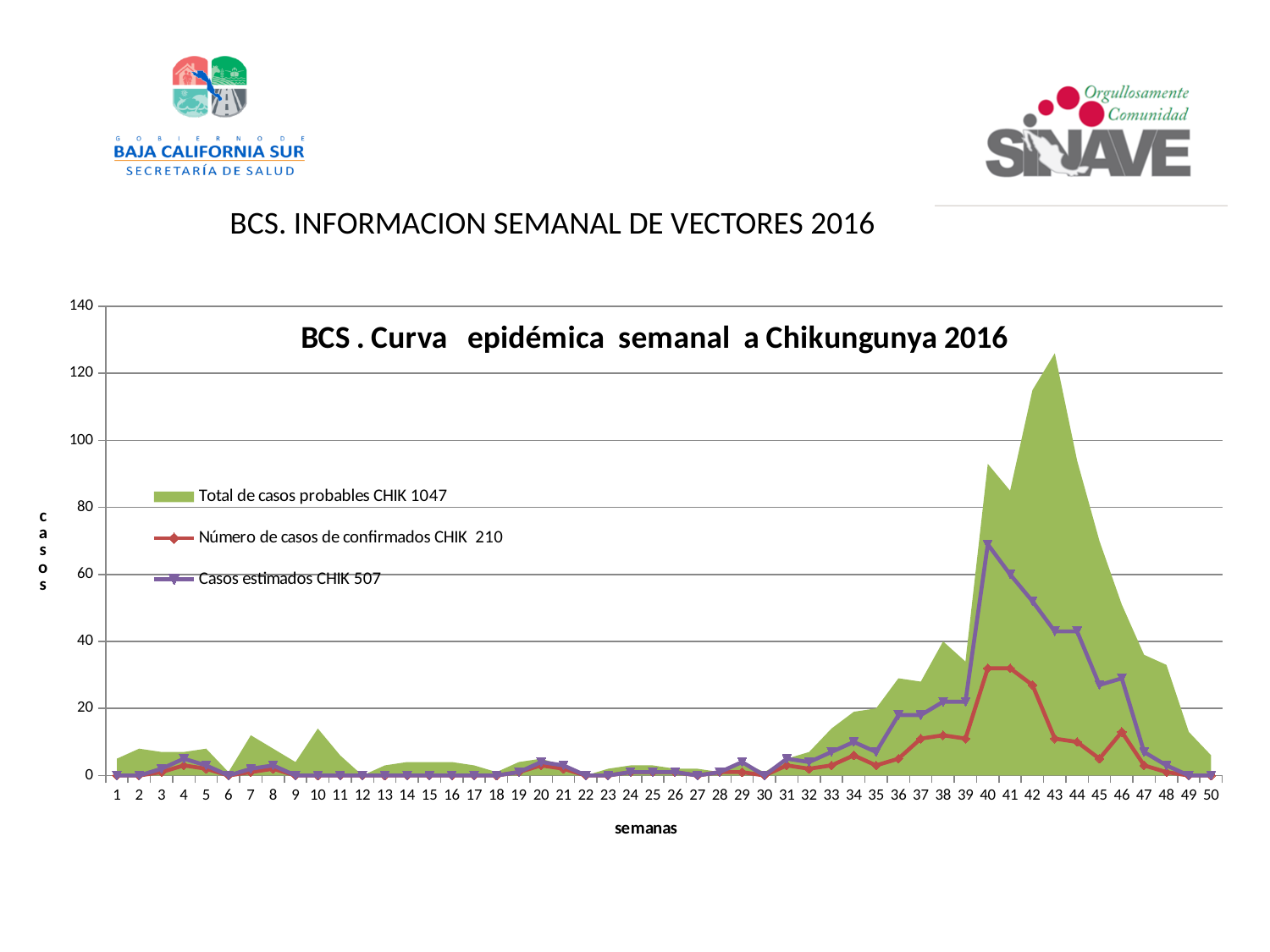
What total number is given in the legend for 'Total de casos probables CHIK'? 1047 From week 43 to week 50, does the 'Total de casos probables CHIK' area rise or fall? fall In week 43, which is larger: 'Casos estimados CHIK' or 'Número de casos de confirmados CHIK'? Casos estimados CHIK Is the value of 'Casos estimados CHIK' in week 40 greater or less than 60? greater Is the value of 'Número de casos de confirmados CHIK' in week 40 greater or less than 40? less How many series does the chart legend list? 3 What is the title of the chart? BCS . Curva epidémica semanal a Chikungunya 2016 Is the value of 'Casos estimados CHIK' in week 46 greater or less than 20? greater How many weeks (semanas) are shown on the x axis? 50 In which week does the green area 'Total de casos probables CHIK' reach its highest value? 43 In which week does the 'Casos estimados CHIK' series reach its highest value? 40